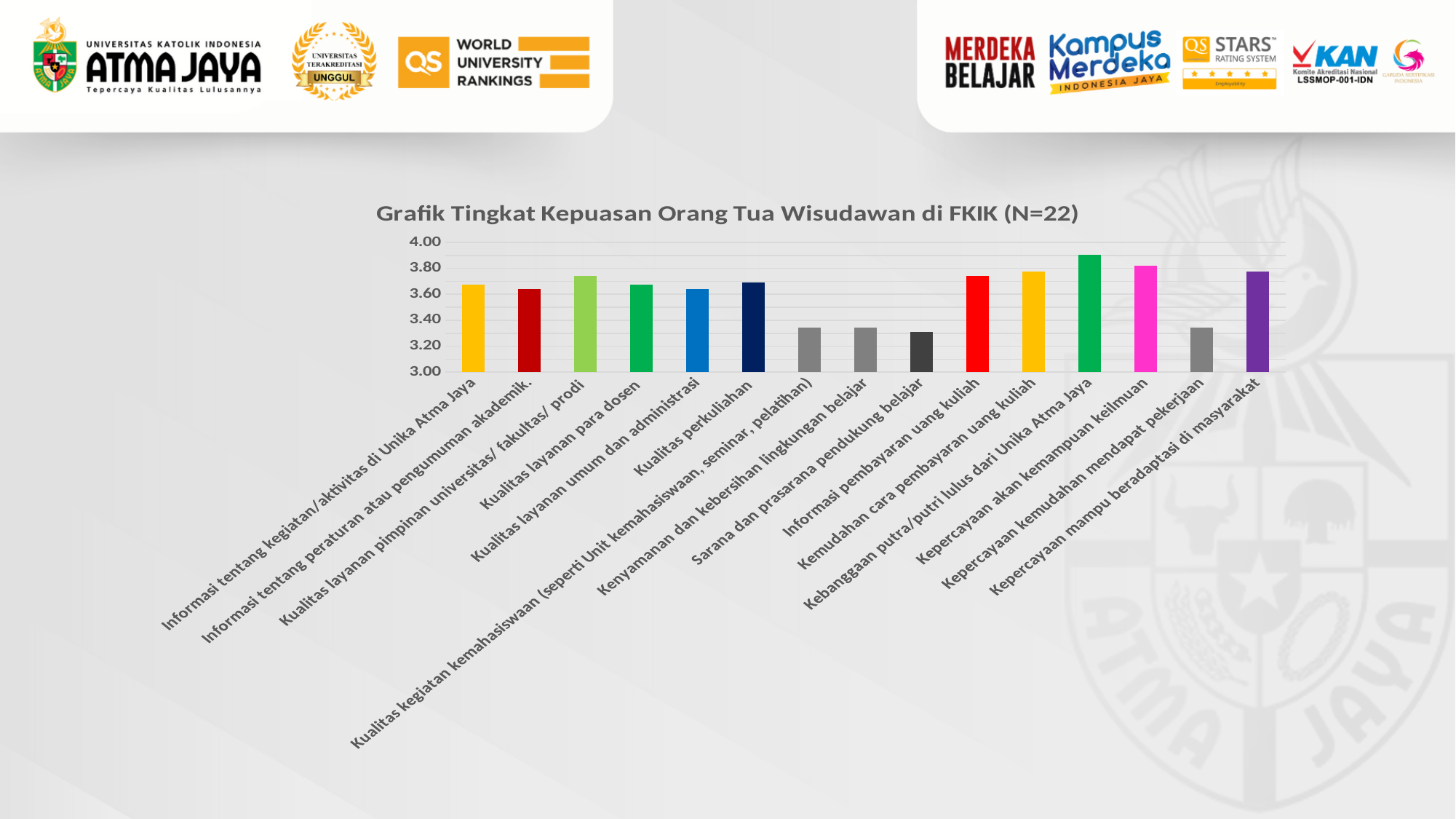
Is the value for Kebanggaan putra/putri lulus dari Unika Atma Jaya greater or less than 3.80? greater Which is larger: the value for Kualitas perkuliahan or the value for Kenyamanan dan kebersihan lingkungan belajar? Kualitas perkuliahan Which is larger: the value for Kebanggaan putra/putri lulus dari Unika Atma Jaya or the value for Kepercayaan kemudahan mendapat pekerjaan? Kebanggaan putra/putri lulus dari Unika Atma Jaya Is the value for Kepercayaan kemudahan mendapat pekerjaan greater or less than 3.40? less What type of chart is shown on the slide? Bar chart Is the value for Kualitas layanan pimpinan universitas/ fakultas/ prodi greater or less than 3.80? less How many categories are plotted in the chart? 15 Which category has the highest value in the chart? Kebanggaan putra/putri lulus dari Unika Atma Jaya What is the title of the chart? Grafik Tingkat Kepuasan Orang Tua Wisudawan di FKIK (N=22) What is the maximum value shown on the vertical axis of the chart? 4.00